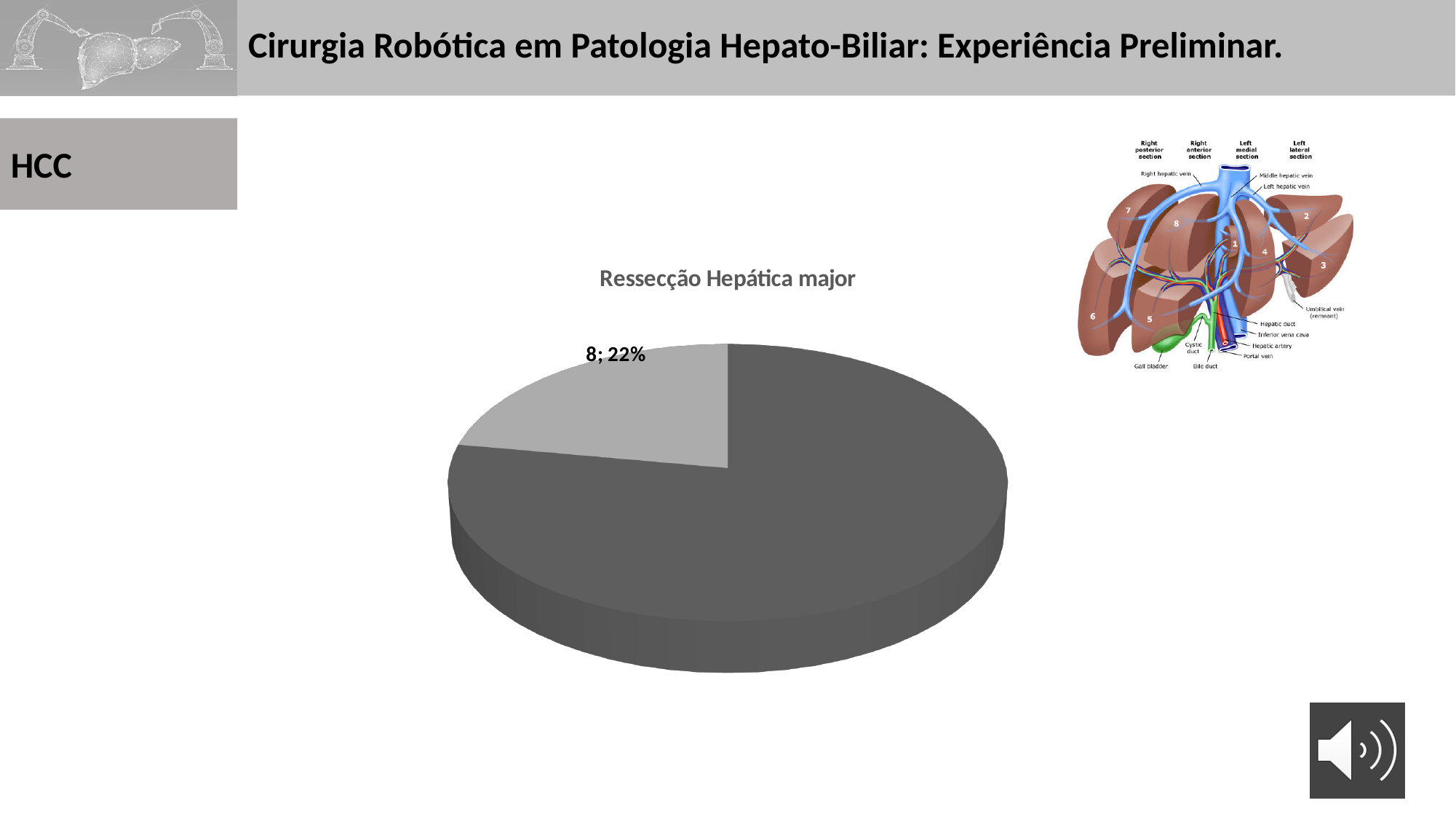
What is the full data label shown on the light grey slice of the pie chart? 8; 22% Which slice of the pie chart is the largest? the dark grey slice How many slices does the pie chart have? 2 What count is printed on the data label of the light grey slice of the pie chart? 8 Which slice of the pie chart is larger, the dark grey slice or the light grey slice? the dark grey slice What kind of chart is shown on the slide? pie chart Which slice of the pie chart is the smallest? the light grey slice What is the title of the pie chart? Ressecção Hepática major Is the share of the light grey slice of the pie chart greater or less than 50%? less What percentage share does the light grey slice of the pie chart represent? 22%